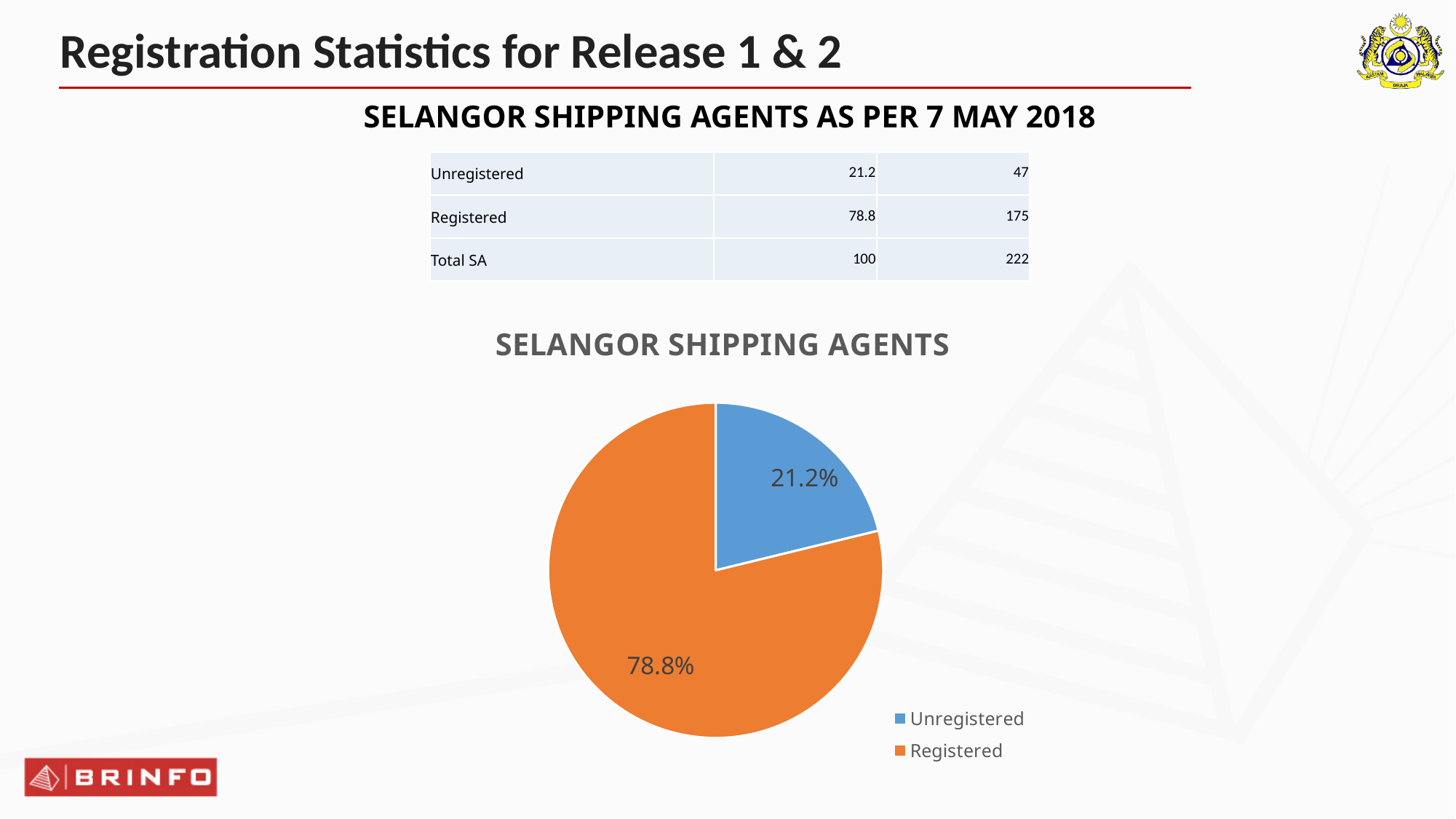
How many slices does the pie chart have? 2 What is the title of the chart? SELANGOR SHIPPING AGENTS What colour is the Registered slice in the pie chart? orange Which category has the smallest slice of the pie? Unregistered What share of the pie does the Registered slice represent? 78.8% Which slice is larger, Registered or Unregistered? Registered What share of the pie does the Unregistered slice represent? 21.2% How many entries does the legend list? 2 What kind of chart is shown on the slide? pie chart What is the difference in percentage points between the Registered and Unregistered slices? 57.6 Which category has the largest slice of the pie? Registered